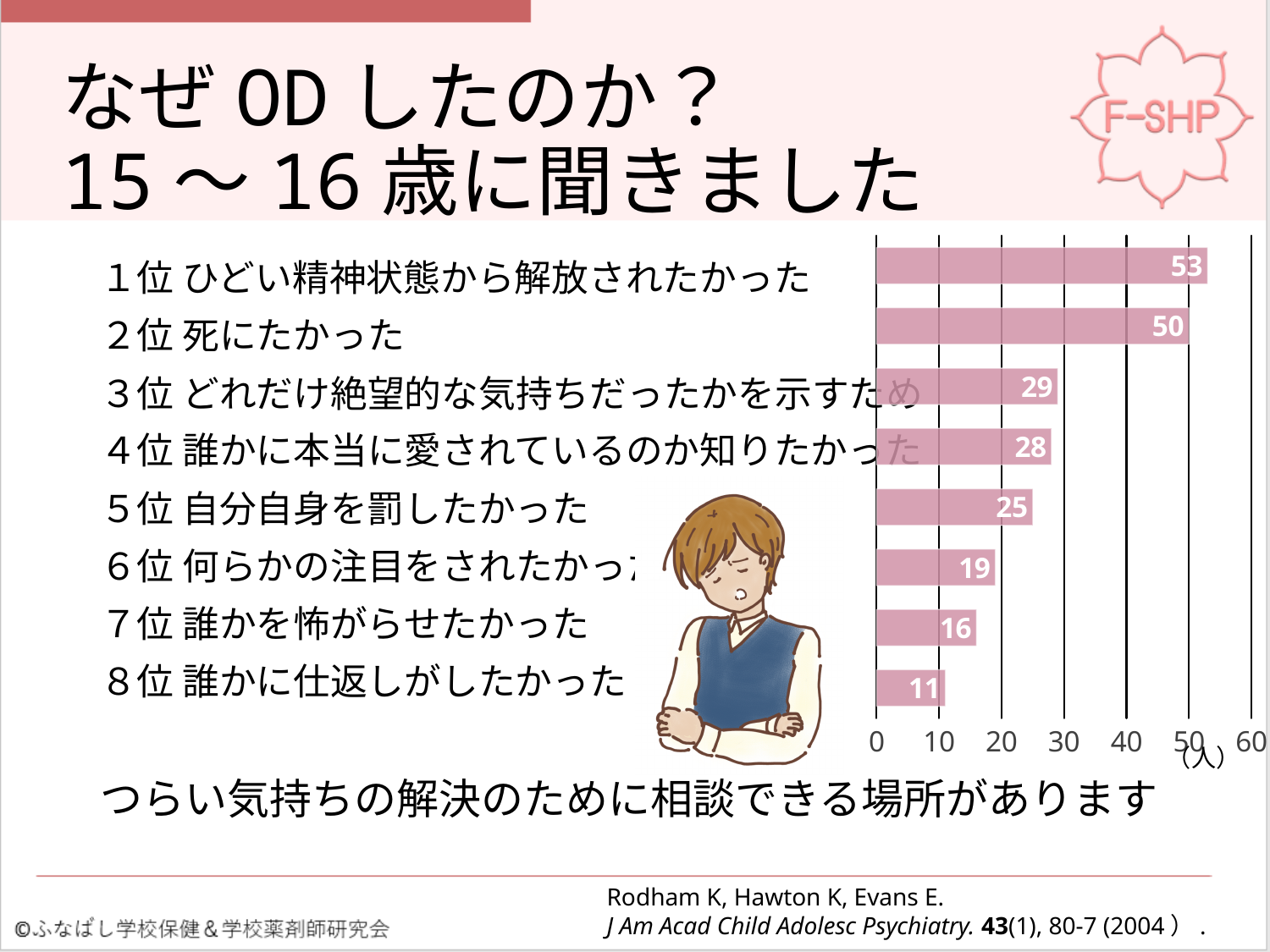
What is the difference between the values for 3位 「どれだけ絶望的な気持ちだったかを示すため」 and 8位 「誰かに仕返しがしたかった」? 18 Which reason has the highest value? ひどい精神状態から解放されたかった (1位) What is the difference between the values for 1位 「ひどい精神状態から解放されたかった」 and 2位 「死にたかった」? 3 What kind of chart is shown on the slide? bar chart Which reason has the lowest value? 誰かに仕返しがしたかった (8位) How many bars (reasons) are shown in the chart? 8 What is the value for 「自分自身を罰したかった」 (5位)? 25 Is the value for 4位 「誰かに本当に愛されているのか知りたかった」 greater or less than 30? less What is the value for 「誰かを怖がらせたかった」 (7位)? 16 Which is larger, the value for 6位 「何らかの注目をされたかった」 or 7位 「誰かを怖がらせたかった」? 何らかの注目をされたかった (6位) What is the value for 「死にたかった」 (2位)? 50 What unit is shown at the end of the horizontal axis? 人